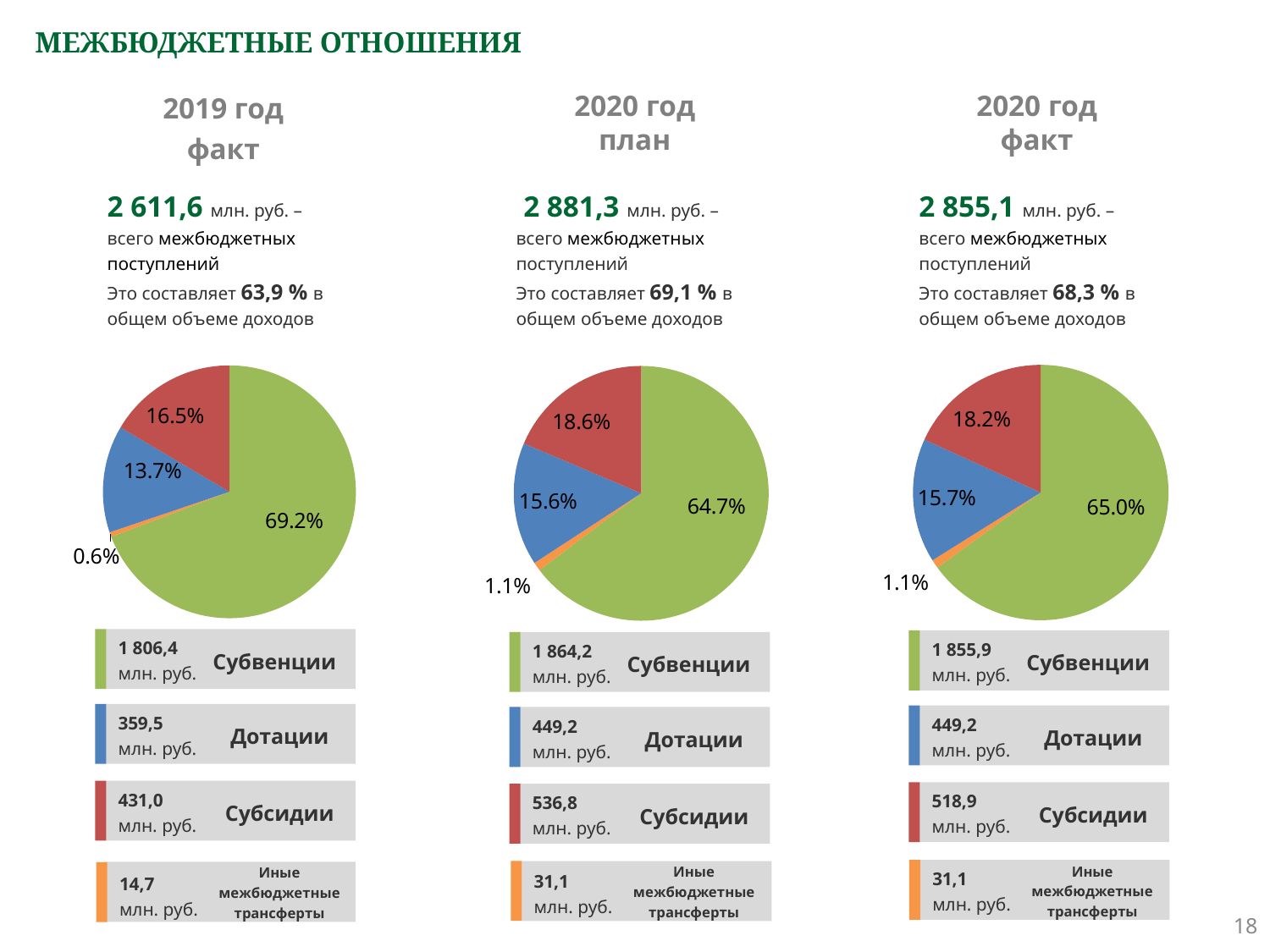
In the 2020 год факт chart, what is the value for Иные межбюджетные трансферты? 31,1 млн. руб. In the 2020 год факт chart, which category has the largest share? Субвенции In the 2020 год факт pie chart, what share does the Дотации slice have? 15.7% What type of chart is used for the 2019 год факт data? pie chart How many slices does each pie chart on the slide have? 4 In the 2019 год факт chart, what is the difference in percentage points between the Субсидии share and the Дотации share? 2.8 In the 2020 год план chart, what is the value for Дотации in млн. руб.? 449,2 млн. руб. In the 2019 год факт chart, which category has the smallest share? Иные межбюджетные трансферты In the 2020 год план chart, which is larger: the Субсидии share or the Дотации share? Субсидии In the 2019 год факт chart, what is the value for Субсидии in млн. руб.? 431,0 млн. руб. In the 2020 год план pie chart, what share does the Субсидии slice have? 18.6% In the 2019 год факт pie chart, what share does the Субвенции slice have? 69.2%